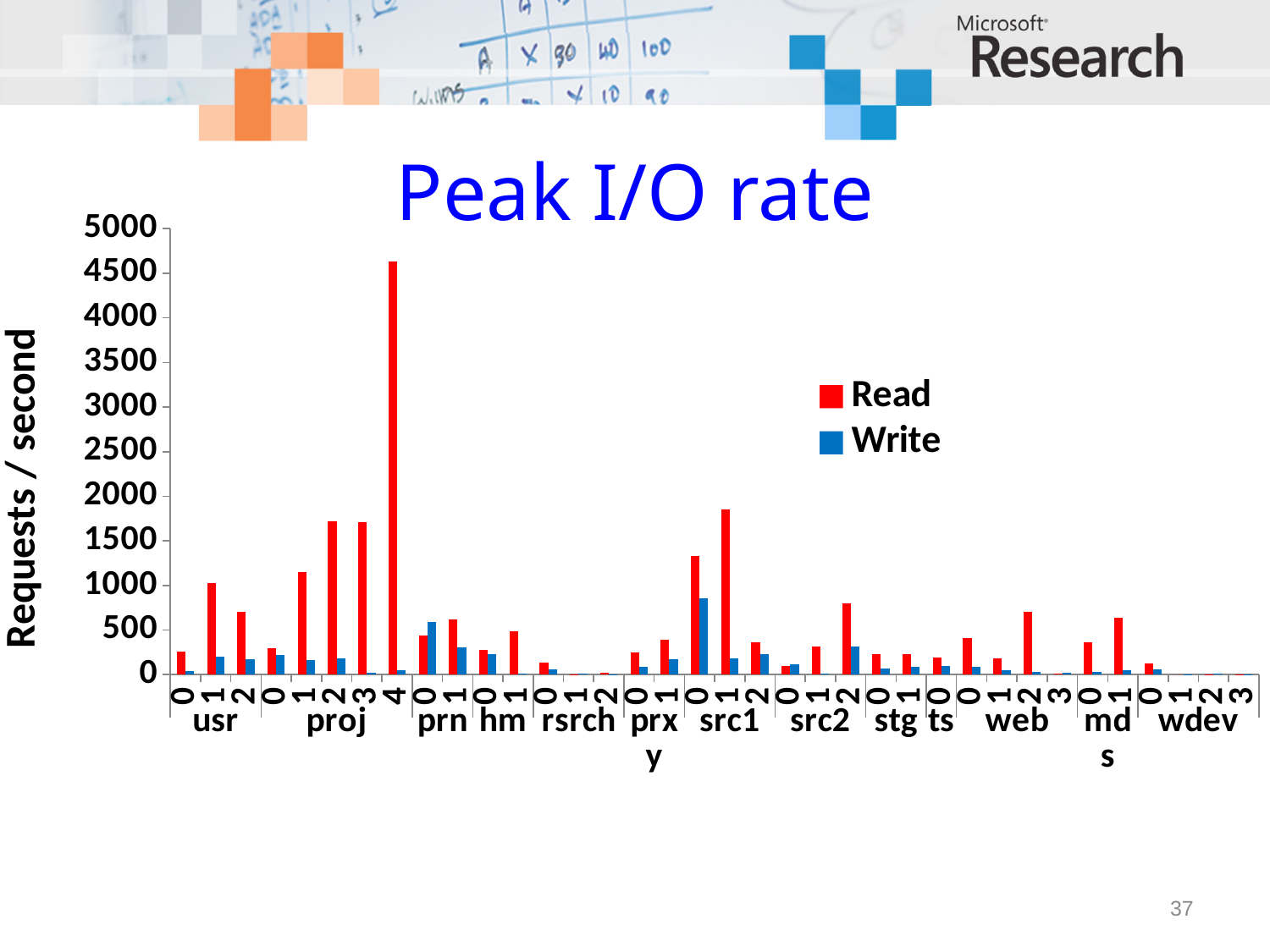
Which is larger, the Read value for proj 4 or the Read value for src1 1? proj 4 How many servers are listed under the proj group on the x axis? 5 What is the title of the chart? Peak I/O rate Is the Read value for src1 1 greater or less than 1500? greater Which server (group and number) has the highest Read value? proj 4 What type of chart is shown on the slide? bar chart Is the Read value for web 2 greater or less than 1000? less What is the label of the vertical axis? Requests / second Is the Write value for src1 0 greater or less than 500? greater How many series does the legend list? 2 Which is larger, the Write value for src1 0 or the Write value for usr 1? src1 0